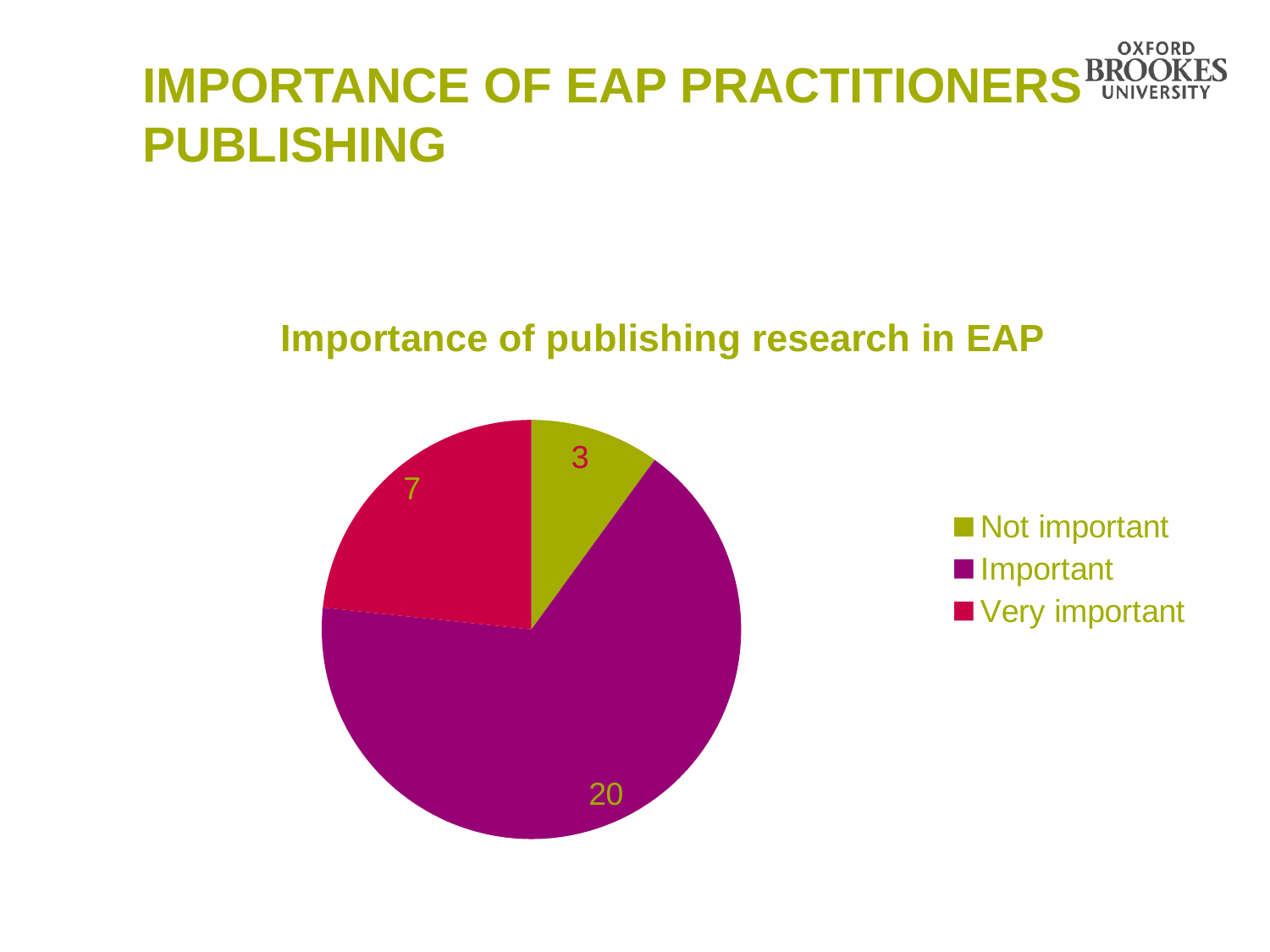
What is the value for Very important? 7 What is the total of all slices in the pie chart? 30 What is the title of the chart? Importance of publishing research in EAP Which is larger, the value for Very important or the value for Not important? Very important What is the value for Important? 20 How many categories does the pie chart have? 3 What type of chart is shown on the slide? pie chart What is the difference between the values for Important and Very important? 13 What share of the pie does Not important represent? 10% Which category has the smallest slice? Not important Which category has the largest slice? Important What is the value for Not important? 3